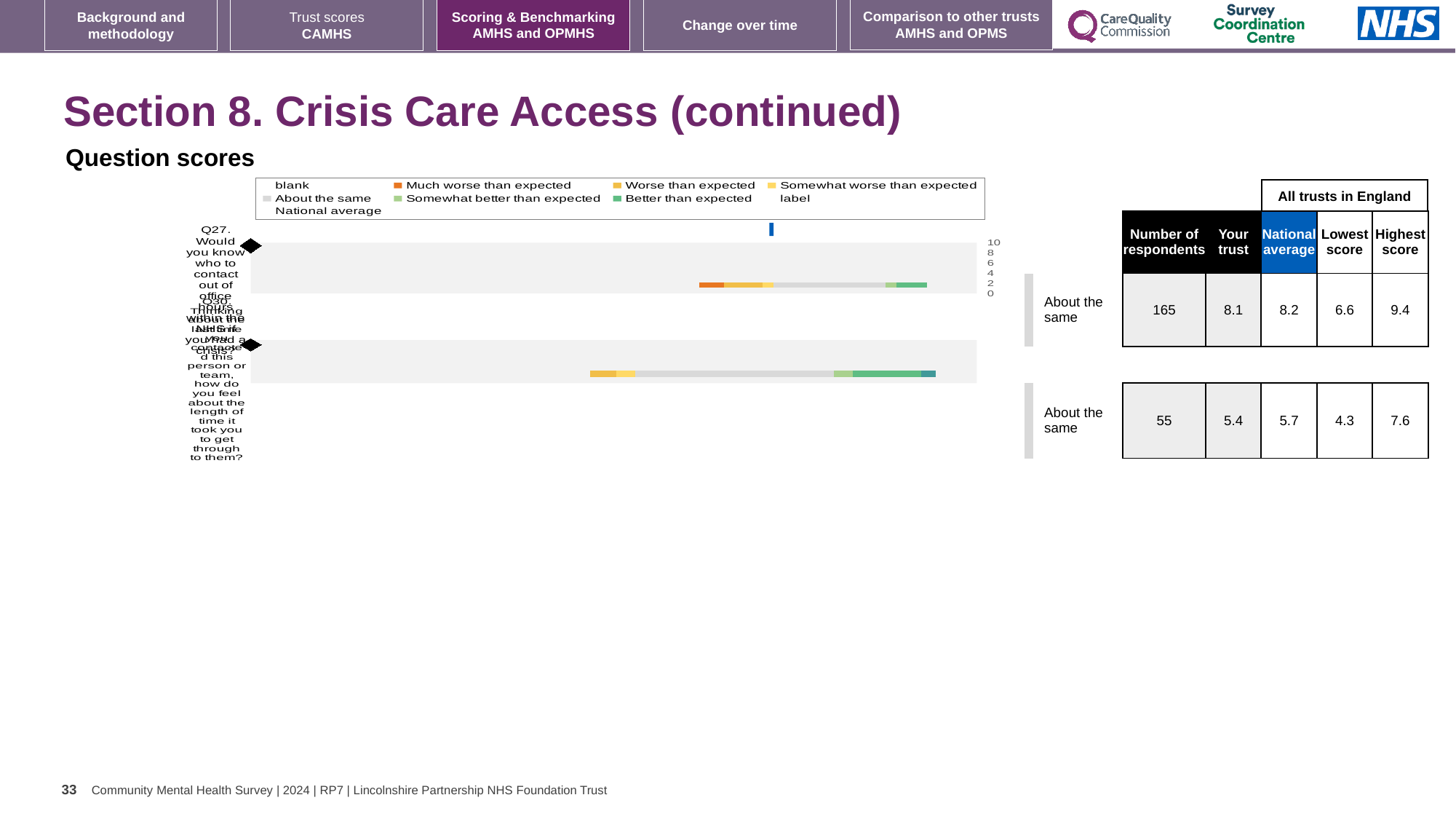
For Q30, how much higher is the national average than the 'Your trust' score? 0.3 What is the highest score among all trusts in England for Q30? 7.6 What is the difference between the highest score and the lowest score for Q27? 2.8 How many questions are plotted in the question scores chart? 2 What is the lowest score among all trusts in England for Q27? 6.6 What kind of chart is used to show the question scores on this slide? Bar chart What is the 'Your trust' score for Q27 (Would you know who to contact out of office hours)? 8.1 What is the national average score for Q27? 8.2 For Q27, which is larger: the 'Your trust' score or the national average? National average What benchmark category is shown next to both Q27 and Q30 in the chart? About the same What is the number of respondents for Q30? 55